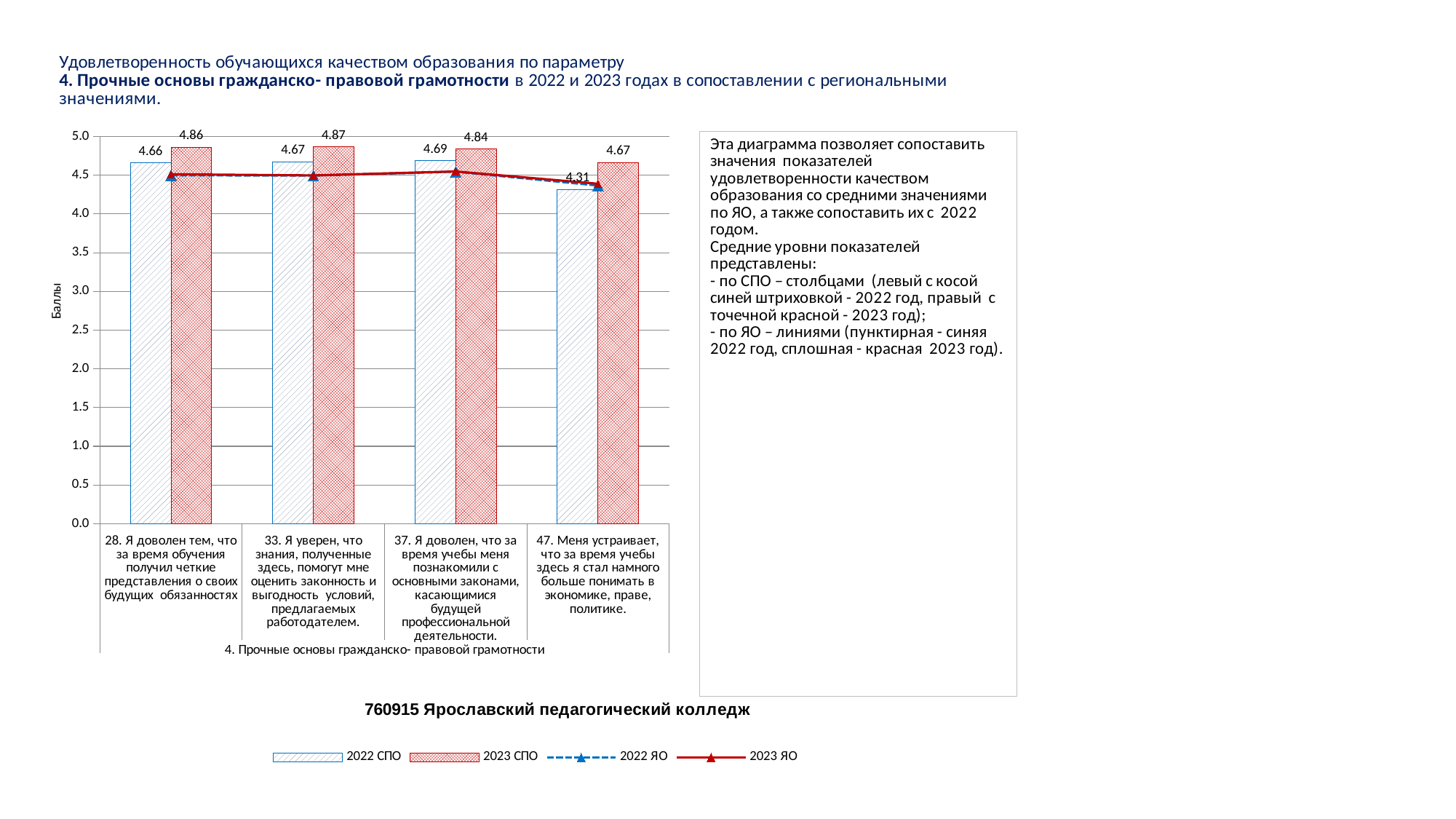
What is the 2023 СПО value for item 33 (Я уверен, что знания, полученные здесь, помогут мне оценить законность и выгодность условий, предлагаемых работодателем)? 4.87 What is the 2022 СПО value for item 47? 4.31 What is the difference between the 2023 СПО and 2022 СПО values for item 47? 0.36 What is the 2022 СПО value for item 28 (Я доволен тем, что за время обучения получил четкие представления о своих будущих обязанностях)? 4.66 Which item has the lowest 2022 СПО value? 47. Меня устраивает, что за время учебы здесь я стал намного больше понимать в экономике, праве, политике. What is the 2023 СПО value for item 47 (Меня устраивает, что за время учебы здесь я стал намного больше понимать в экономике, праве, политике)? 4.67 What is the label of the vertical axis of the chart? Баллы Is the 2023 ЯО value for item 47 greater or less than 4.5? less Which item has the highest 2023 СПО value? 33. Я уверен, что знания, полученные здесь, помогут мне оценить законность и выгодность условий, предлагаемых работодателем. How many items (categories) are shown on the x axis of the chart? 4 For item 37, which is larger: the 2022 СПО value or the 2023 СПО value? 2023 СПО How many series does the chart legend list? 4